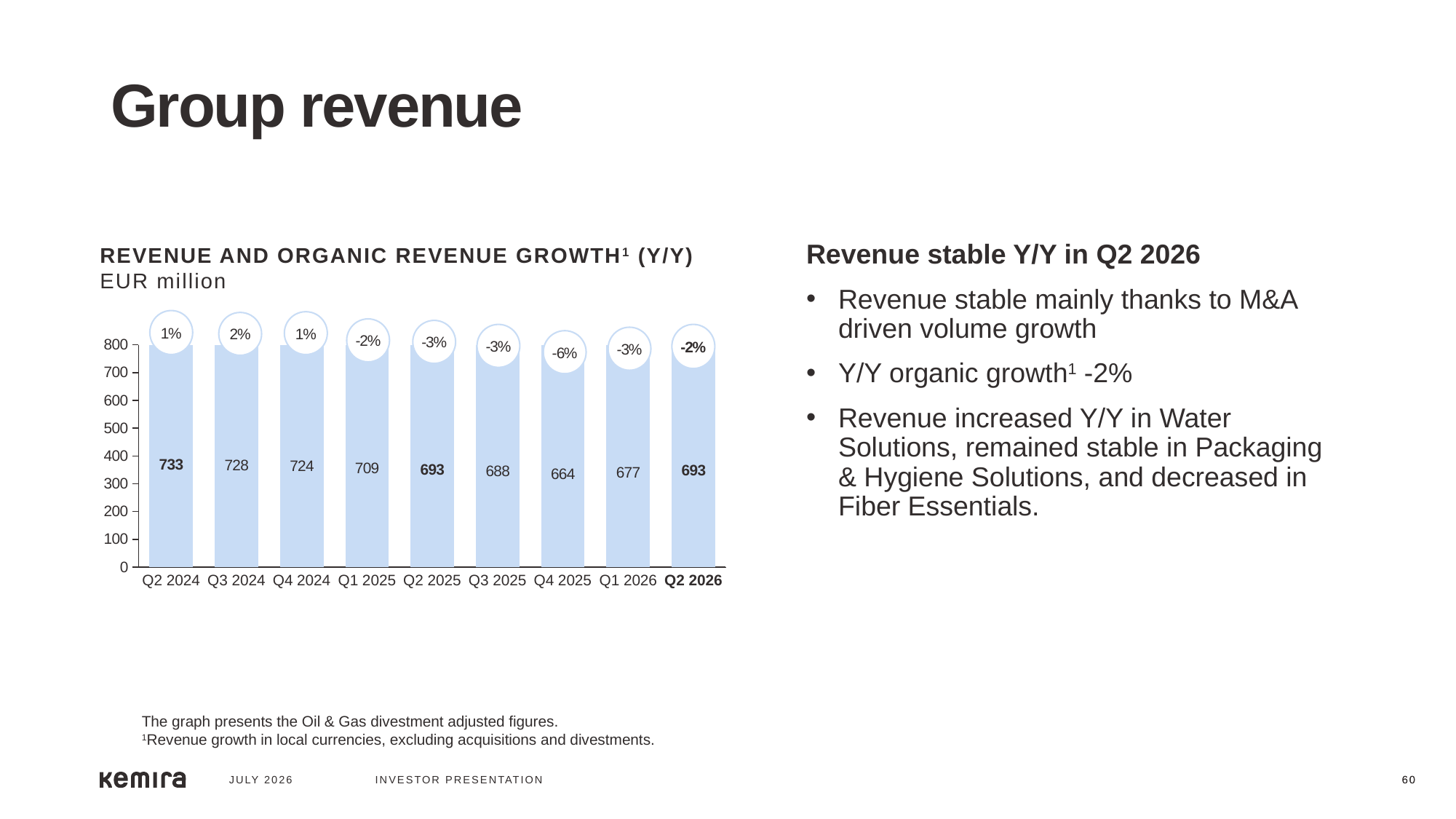
What unit is the chart's revenue measured in, according to the subtitle? EUR million Does revenue generally rise or fall from Q2 2024 to Q4 2025? fall How many quarters are shown on the chart? 9 What kind of chart is used to show revenue? bar chart What is the difference in revenue between Q2 2024 and Q2 2025? 40 Which quarter has higher revenue, Q1 2026 or Q4 2025? Q1 2026 Which quarter has the highest revenue? Q2 2024 What is the organic revenue growth shown for Q4 2025? -6% What is the revenue value for Q2 2026? 693 Which quarter has the lowest revenue? Q4 2025 Is the revenue for Q3 2025 greater or less than 700? less What is the organic revenue growth shown for Q3 2024? 2%